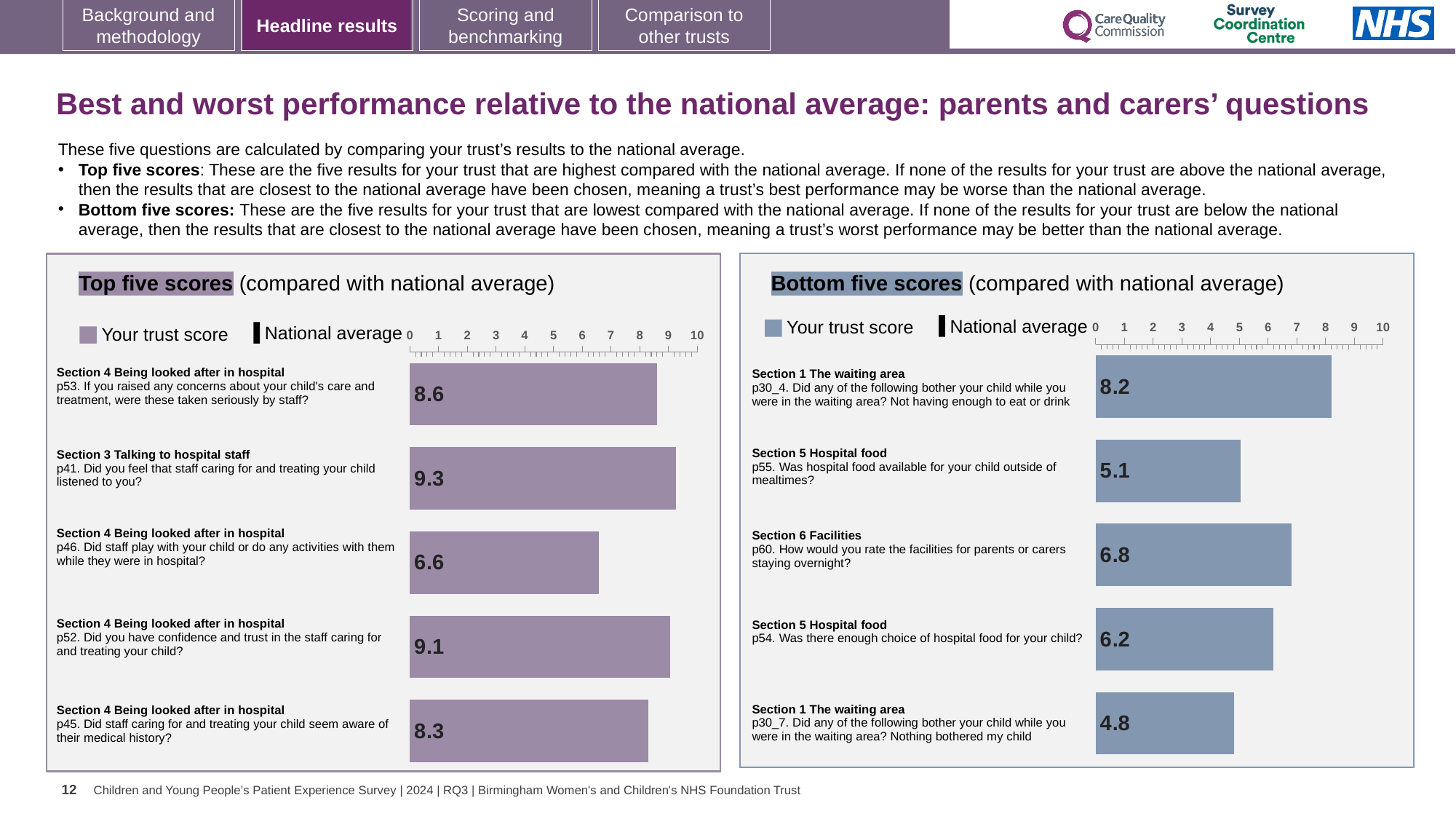
What type of chart is the Bottom five scores chart? Bar chart In the Bottom five scores chart, what is the difference between the trust scores for p30_4 and p54? 2.0 In the Top five scores chart, what is the difference between the trust scores for p52 and p45? 0.8 In the Top five scores chart, which question has the highest trust score? p41. Did you feel that staff caring for and treating your child listened to you? In the Bottom five scores chart, which question has the lowest trust score? p30_7. Did any of the following bother your child while you were in the waiting area? Nothing bothered my child In the Bottom five scores chart, what is the trust score for p55 (Was hospital food available for your child outside of mealtimes?)? 5.1 In the Top five scores chart, what is the trust score for p41 (Did you feel that staff caring for and treating your child listened to you?)? 9.3 How many bars are plotted in the Top five scores chart? 5 In the Bottom five scores chart, what is the trust score for p60 (How would you rate the facilities for parents or carers staying overnight?)? 6.8 In the Bottom five scores chart, which has the larger trust score: p60 or p54? p60 In the Top five scores chart, what is the trust score for p46 (Did staff play with your child or do any activities with them while they were in hospital?)? 6.6 How many series does the legend of the Top five scores chart list? 2